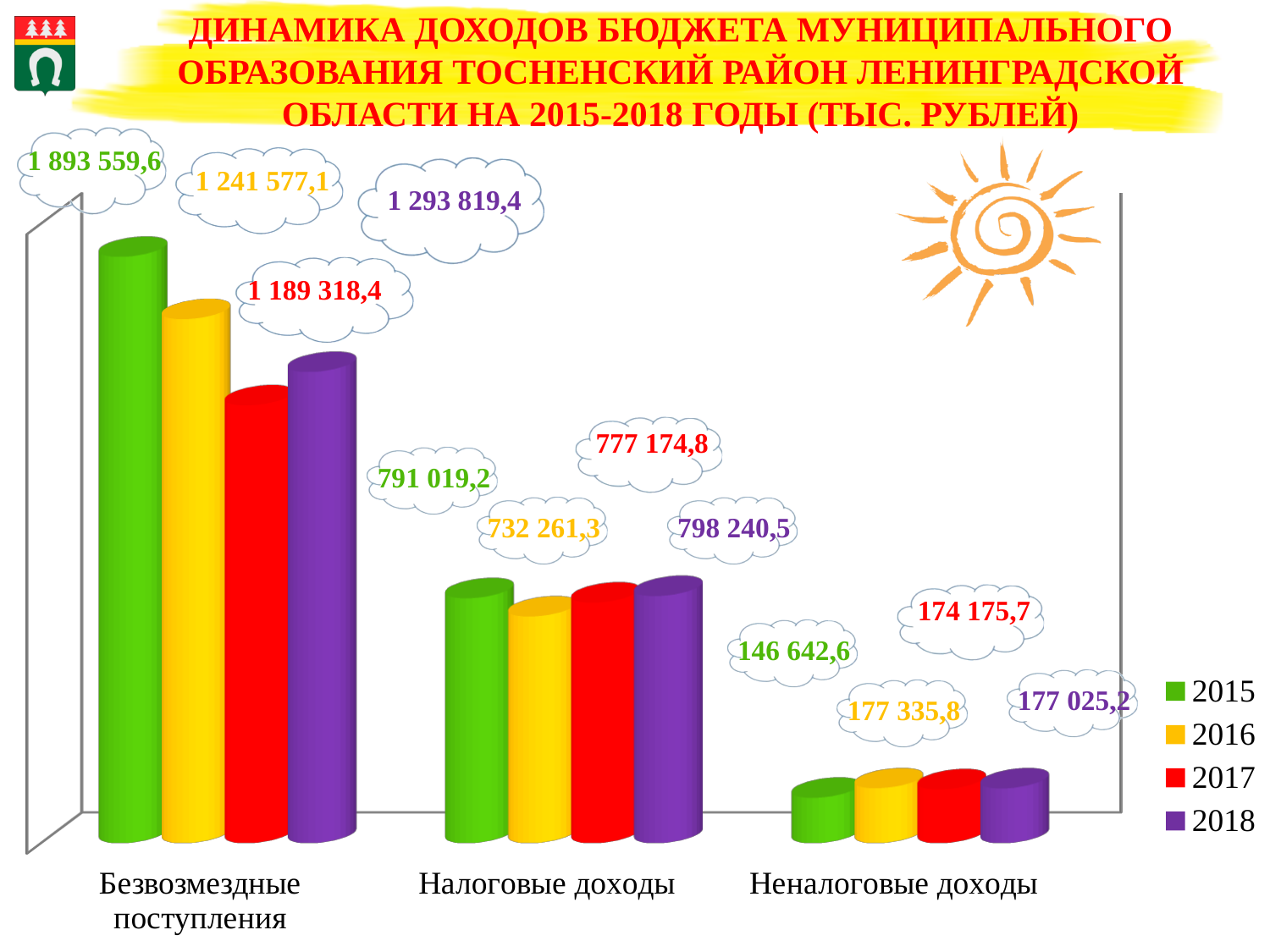
How many categories are shown on the x axis? 3 Which is larger for Безвозмездные поступления: the 2017 value or the 2018 value? 2018 Which year has the highest value for Налоговые доходы? 2018 What is the value for Безвозмездные поступления in 2017? 1 189 318,4 What type of chart is shown on the slide? bar chart How many series does the legend list? 4 What is the difference between the 2015 and 2016 values for Безвозмездные поступления? 651 982,5 Which year has the lowest value for Неналоговые доходы? 2015 What is the value for Безвозмездные поступления in 2015? 1 893 559,6 Which colour represents the 2017 series in the legend? red What is the value for Неналоговые доходы in 2016? 177 335,8 What is the value for Налоговые доходы in 2018? 798 240,5